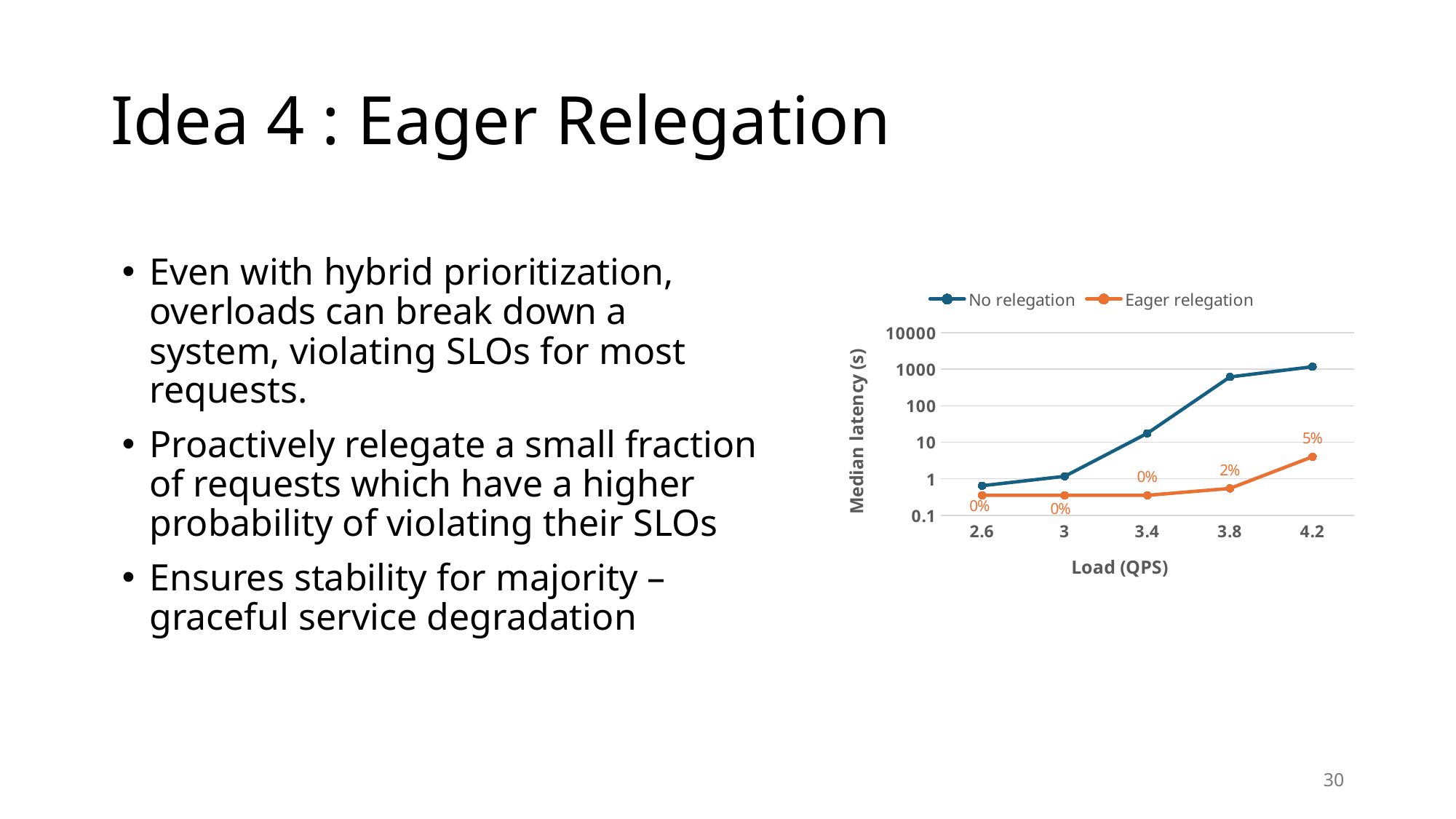
What percentage label is shown on the Eager relegation point at a load of 4.2 QPS? 5% How many series does the chart legend list? 2 Does the median latency for No relegation rise or fall as load increases from 2.6 to 4.2 QPS? rise At a load of 4.2 QPS, which series has the higher median latency, No relegation or Eager relegation? No relegation What is the label of the y axis of the chart? Median latency (s) What are the two series named in the chart legend? No relegation and Eager relegation How many load (QPS) values are plotted along the x axis of the chart? 5 What kind of chart is shown on the slide? line chart Is the median latency for Eager relegation at a load of 2.6 QPS greater or less than 1? less Is the median latency for Eager relegation at a load of 4.2 QPS greater or less than 10? less Is the median latency for No relegation at a load of 3.4 QPS greater or less than 10? greater